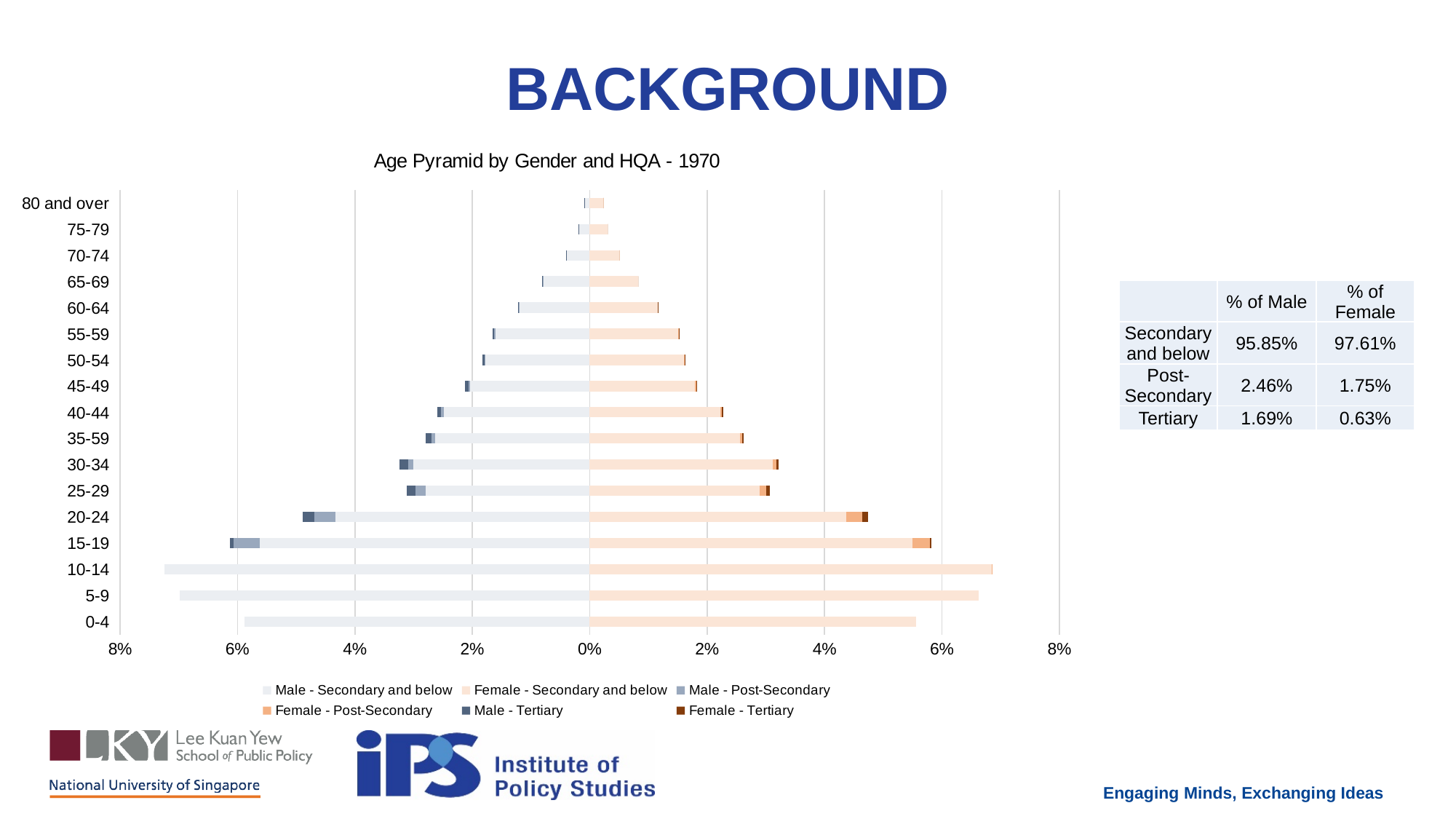
What kind of chart is shown on the slide? Bar chart Is the total female value for the 20-24 age group greater or less than 4%? greater Is the total female value for the 0-4 age group greater or less than 6%? less Which is larger: the female bar for the 5-9 age group or the female bar for the 0-4 age group? 5-9 Is the total male value for the 65-69 age group greater or less than 2%? less Which age group has the longest male bar in the chart? 10-14 How many age groups are shown on the vertical axis of the chart? 17 Which age group has the longest female bar in the chart? 10-14 What is the title of the chart? Age Pyramid by Gender and HQA - 1970 How many series does the chart legend list? 6 Which age group has the shortest bars in the chart? 80 and over